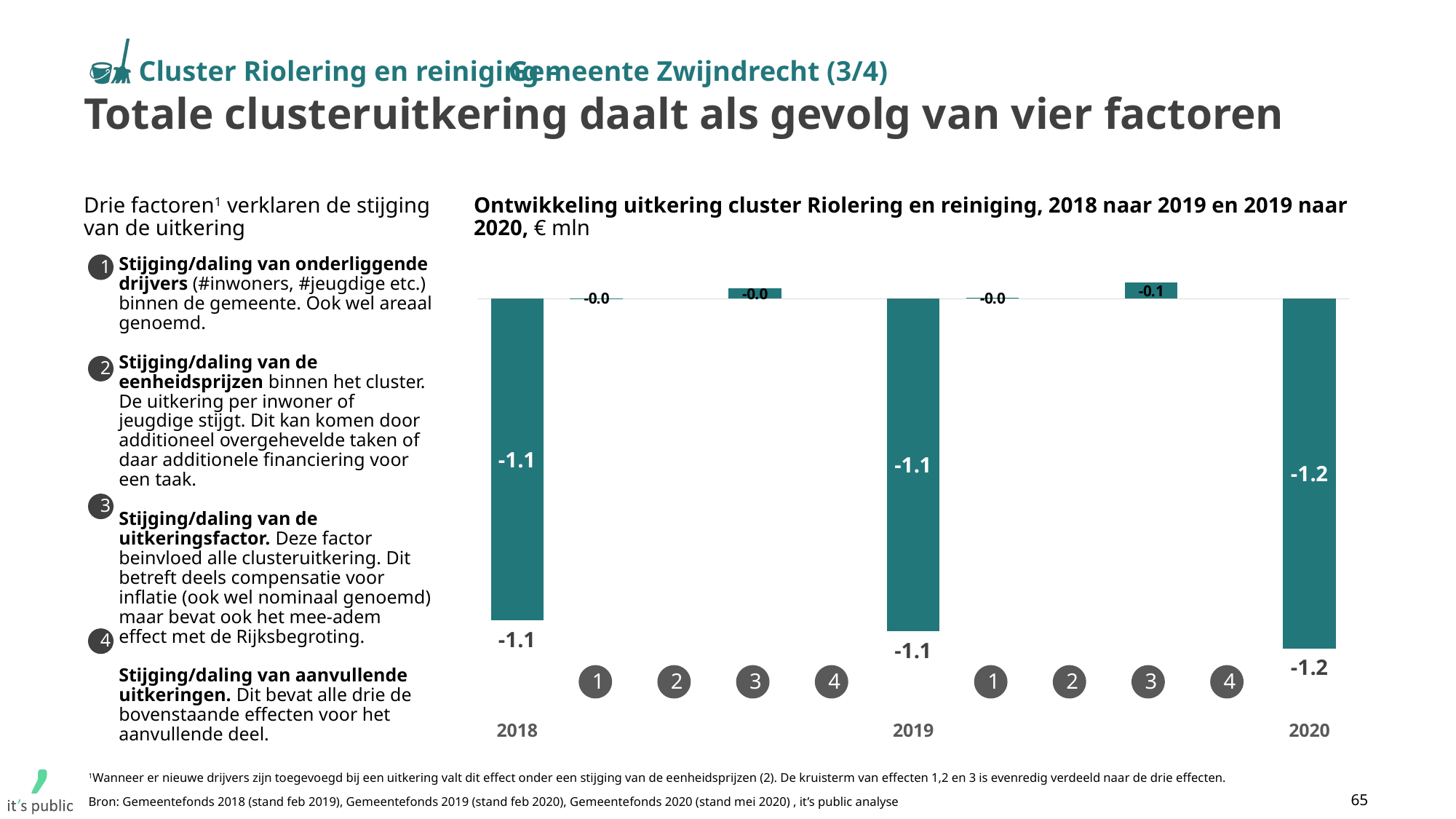
How many year totals (2018, 2019, 2020) are shown as large bars in the chart? 3 What is the value labelled for factor 3 between 2019 and 2020 in the chart? -0.1 What is the value of the 2020 bar in the chart? -1.2 In what unit are the values in the chart expressed? € mln What type of chart is shown on the slide? Bar chart Which year has the lowest (most negative) total value in the chart: 2018, 2019 or 2020? 2020 What is the difference between the 2018 value and the 2020 value in the chart? 0.1 Do the year totals in the chart rise or fall from 2018 to 2020? Fall What is the value of the 2018 bar in the chart 'Ontwikkeling uitkering cluster Riolering en reiniging'? -1.1 What is the value of the 2019 bar in the chart? -1.1 What is the value labelled for factor 1 between 2019 and 2020 in the chart? -0.0 Which is larger in the chart, the value for 2019 or the value for 2020? 2019